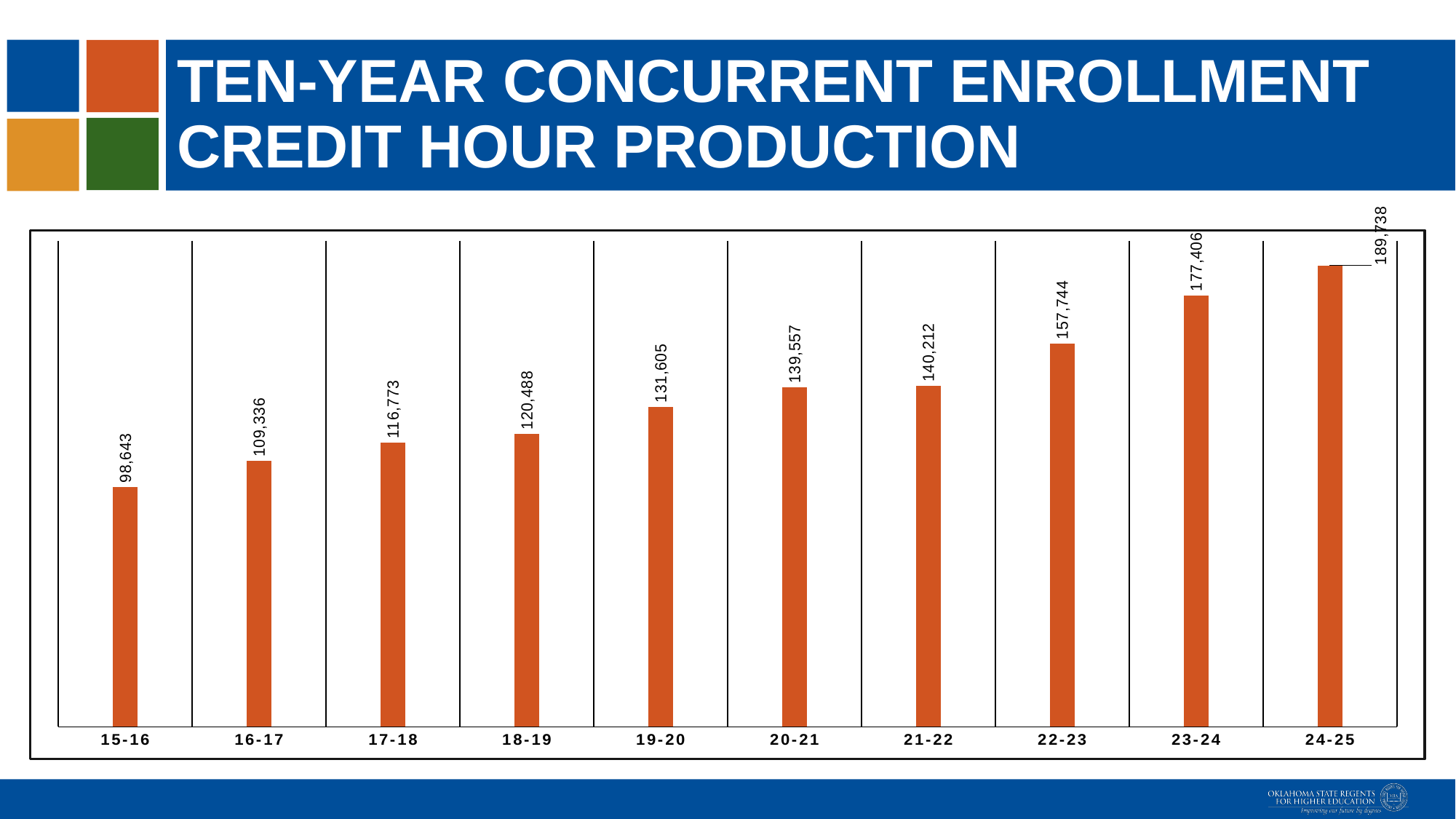
Do the values generally rise or fall from 15-16 to 24-25? rise What is the credit hour production value for 19-20? 131,605 What is the credit hour production value for 24-25? 189,738 What kind of chart is shown on the slide? bar chart What is the difference between the values for 24-25 and 23-24? 12,332 Which is larger, the value for 18-19 or the value for 17-18? 18-19 Which academic year has the lowest credit hour production? 15-16 Which academic year has the highest credit hour production? 24-25 How many academic years are shown on the chart? 10 What is the difference between the values for 22-23 and 21-22? 17,532 What is the credit hour production value for 15-16? 98,643 What is the title of the slide? Ten-Year Concurrent Enrollment Credit Hour Production